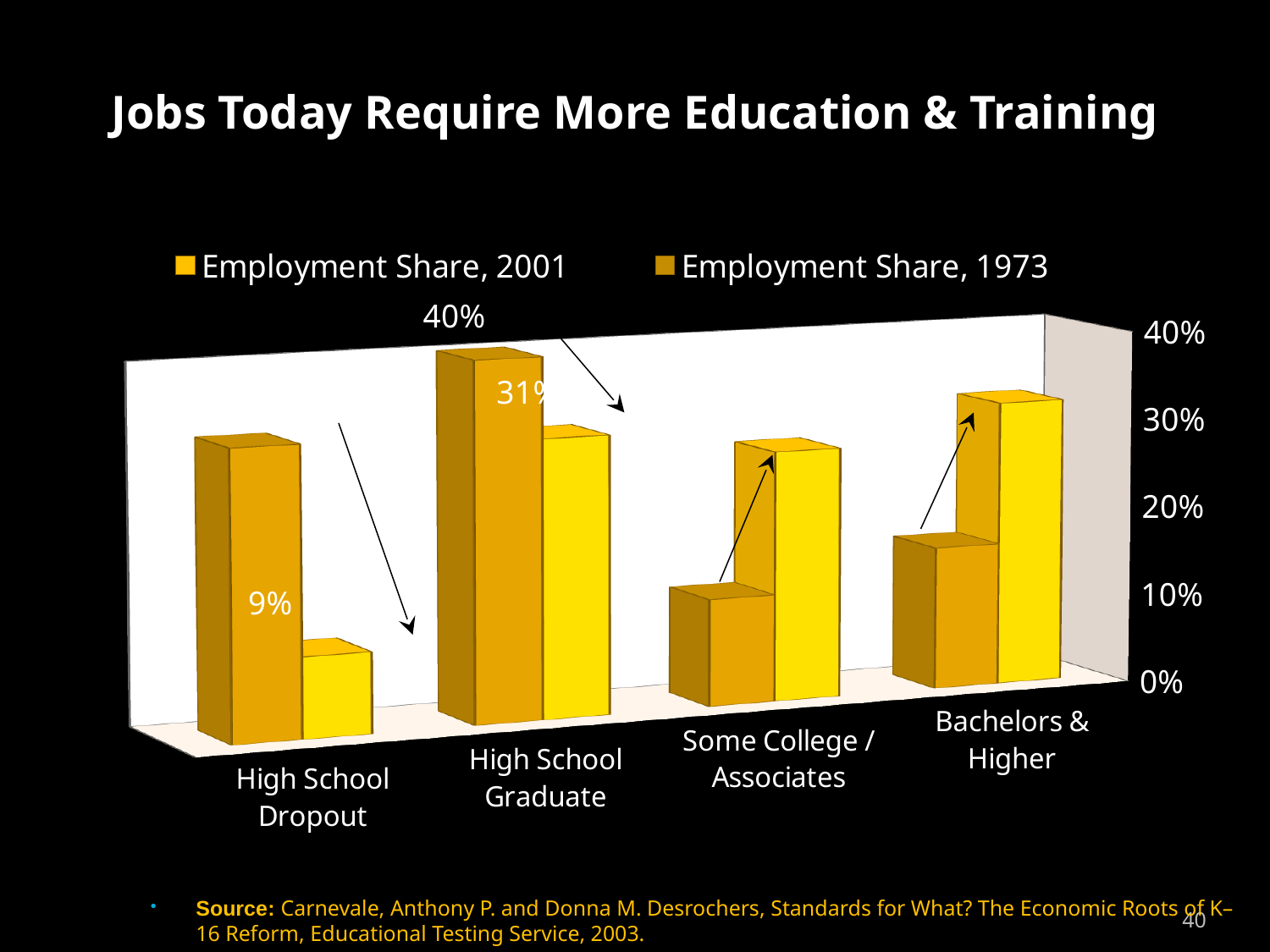
For High School Dropout, which series has the larger bar, Employment Share, 2001 or Employment Share, 1973? Employment Share, 1973 What are the two series named in the legend? Employment Share, 2001 and Employment Share, 1973 Is the Employment Share, 2001 value for High School Graduate greater or less than 30%? greater For Some College / Associates, which series has the larger bar, Employment Share, 2001 or Employment Share, 1973? Employment Share, 2001 What is the title of the slide's chart? Jobs Today Require More Education & Training Is the Employment Share, 2001 value for Some College / Associates greater or less than 20%? greater How many education categories are shown on the x axis? 4 What kind of chart is shown on the slide? Bar chart Which category has the tallest Employment Share, 2001 bar? Bachelors & Higher Which category has the shortest Employment Share, 1973 bar? Some College / Associates Is the Employment Share, 1973 value for High School Dropout greater or less than 20%? greater How many series does the legend list? 2